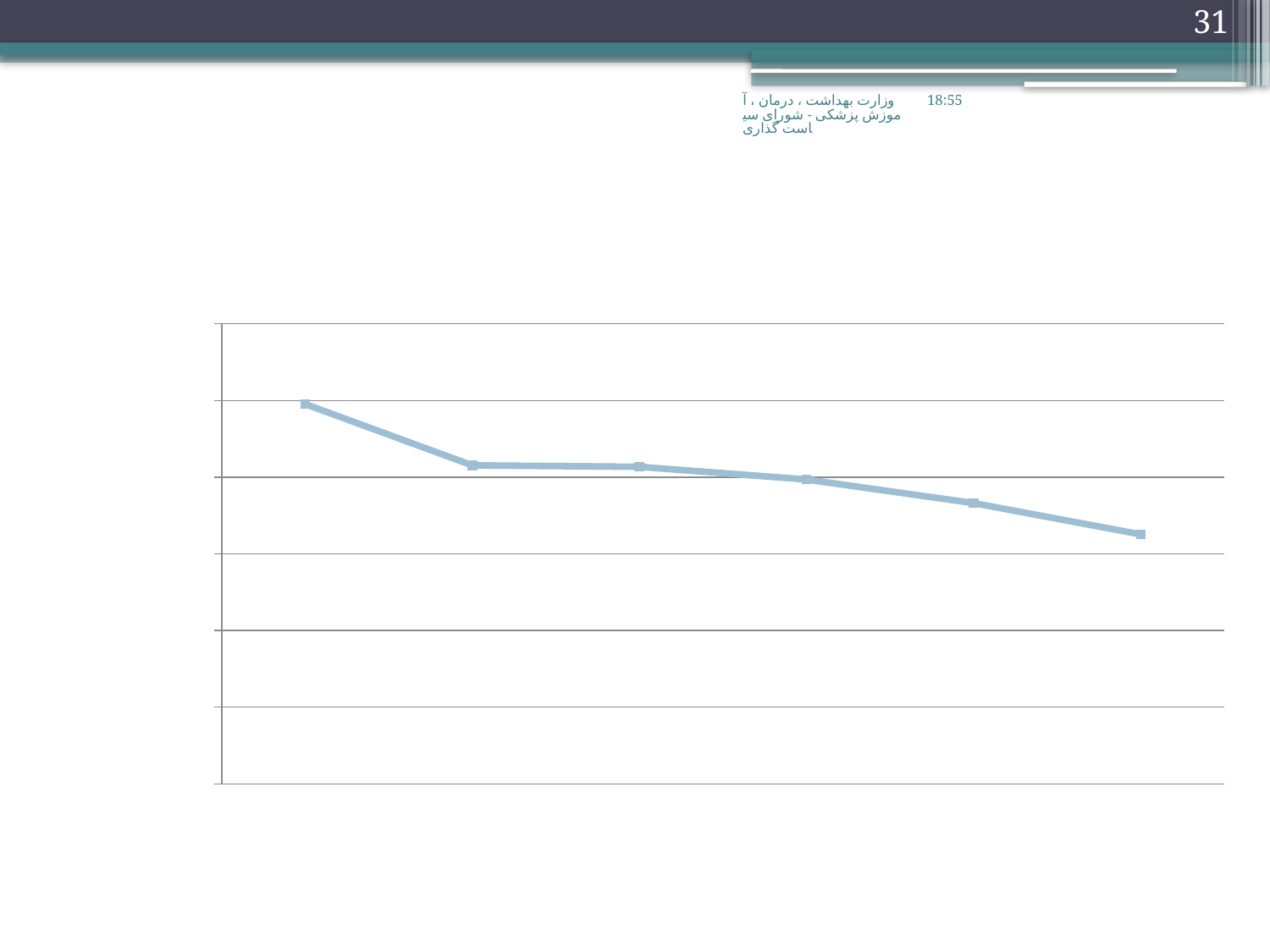
What kind of chart is shown on the slide? line chart How many lines are plotted on the chart? 1 Which is higher, the leftmost point or the rightmost point on the line? the leftmost point How many data points are plotted on the line? 6 Do the values rise or fall from left to right along the x axis? fall